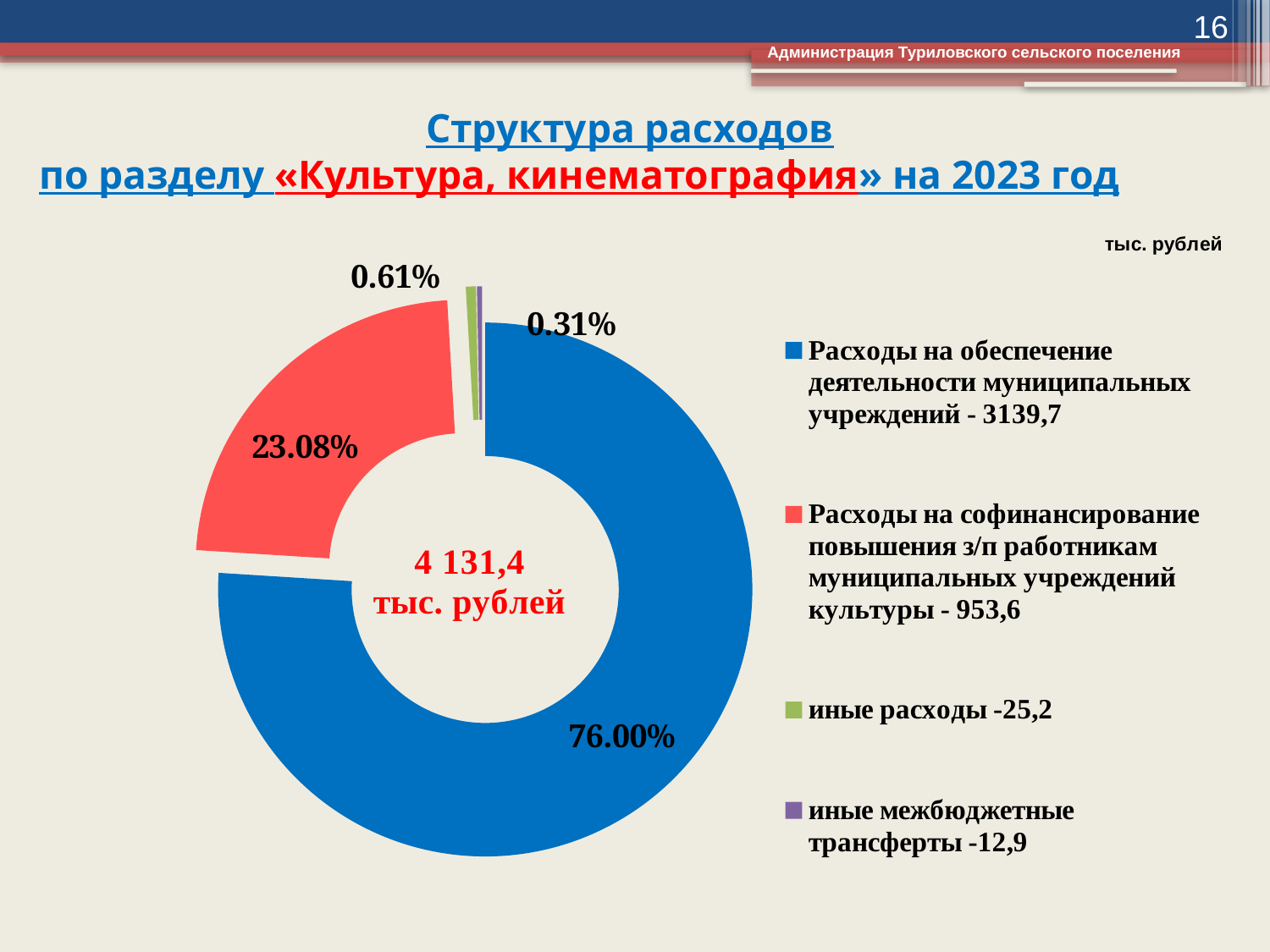
What total amount is shown in the centre of the chart? 4 131,4 тыс. рублей Which category has the largest share of expenses? Расходы на обеспечение деятельности муниципальных учреждений How many categories does the legend list? 4 What share of expenses is shown for «Расходы на софинансирование повышения з/п работникам муниципальных учреждений культуры»? 23.08% What kind of chart is shown on the slide? Doughnut (pie) chart Which category has the smallest share of expenses? иные межбюджетные трансферты What share of expenses is shown for «иные межбюджетные трансферты»? 0.31% What share of expenses is shown for «Расходы на обеспечение деятельности муниципальных учреждений»? 76.00% What is the value (тыс. рублей) for «иные межбюджетные трансферты» in the legend? 12,9 Which is larger: the share for «иные расходы» or the share for «иные межбюджетные трансферты»? иные расходы What is the value (тыс. рублей) for «Расходы на обеспечение деятельности муниципальных учреждений» in the legend? 3139,7